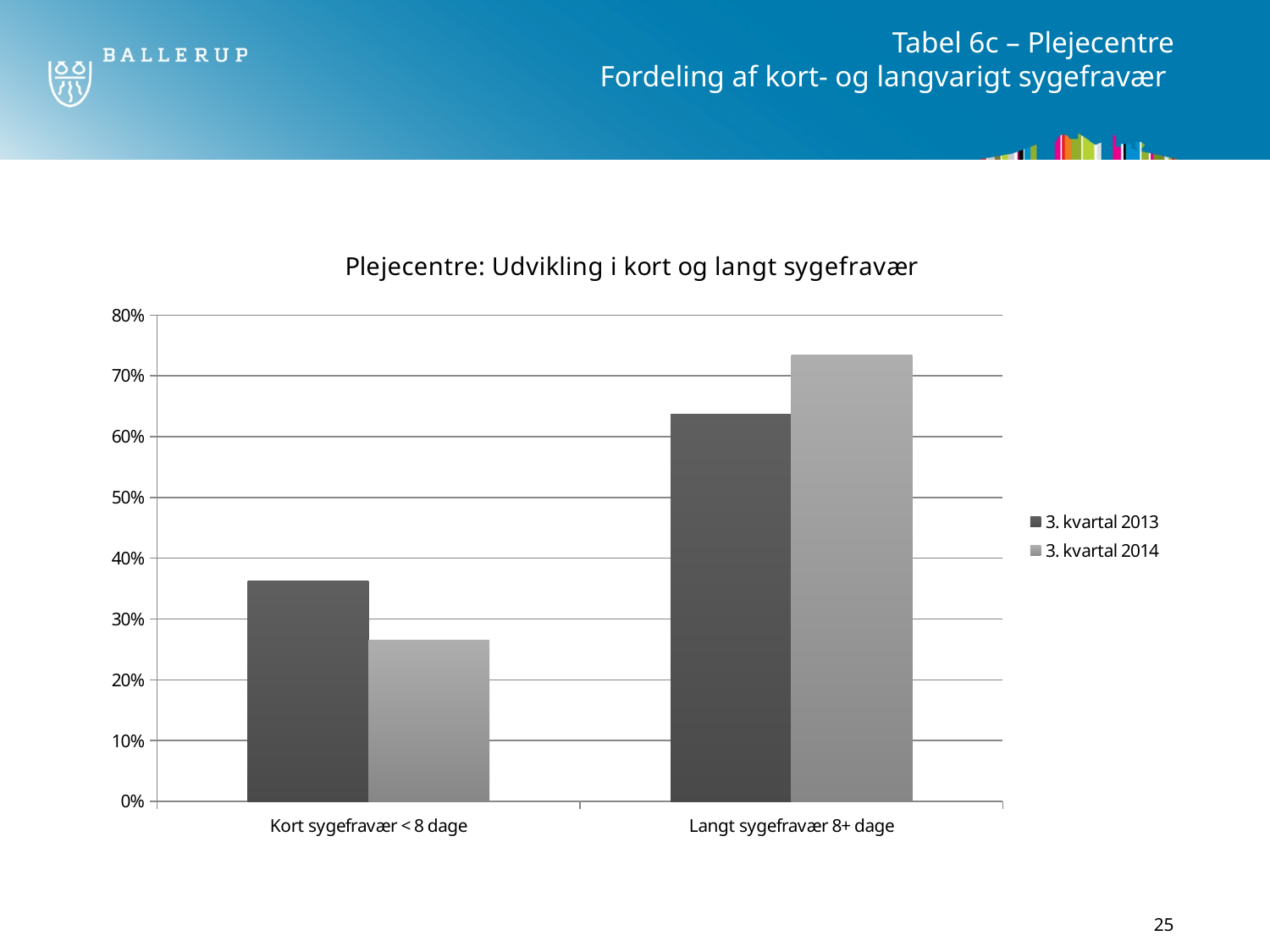
Which series does the legend list first? 3. kvartal 2013 Which is larger for Kort sygefravær < 8 dage: the 3. kvartal 2013 value or the 3. kvartal 2014 value? 3. kvartal 2013 How many categories are shown on the x axis? 2 What is the title of the chart? Plejecentre: Udvikling i kort og langt sygefravær Is the value for Kort sygefravær < 8 dage in 3. kvartal 2013 greater or less than 30%? greater Which is larger for Langt sygefravær 8+ dage: the 3. kvartal 2013 value or the 3. kvartal 2014 value? 3. kvartal 2014 Is the value for Langt sygefravær 8+ dage in 3. kvartal 2013 greater or less than 60%? greater Which category has the highest bar in the chart? Langt sygefravær 8+ dage Is the value for Langt sygefravær 8+ dage in 3. kvartal 2014 greater or less than 70%? greater How many series does the legend list? 2 What type of chart is shown on the slide? bar chart